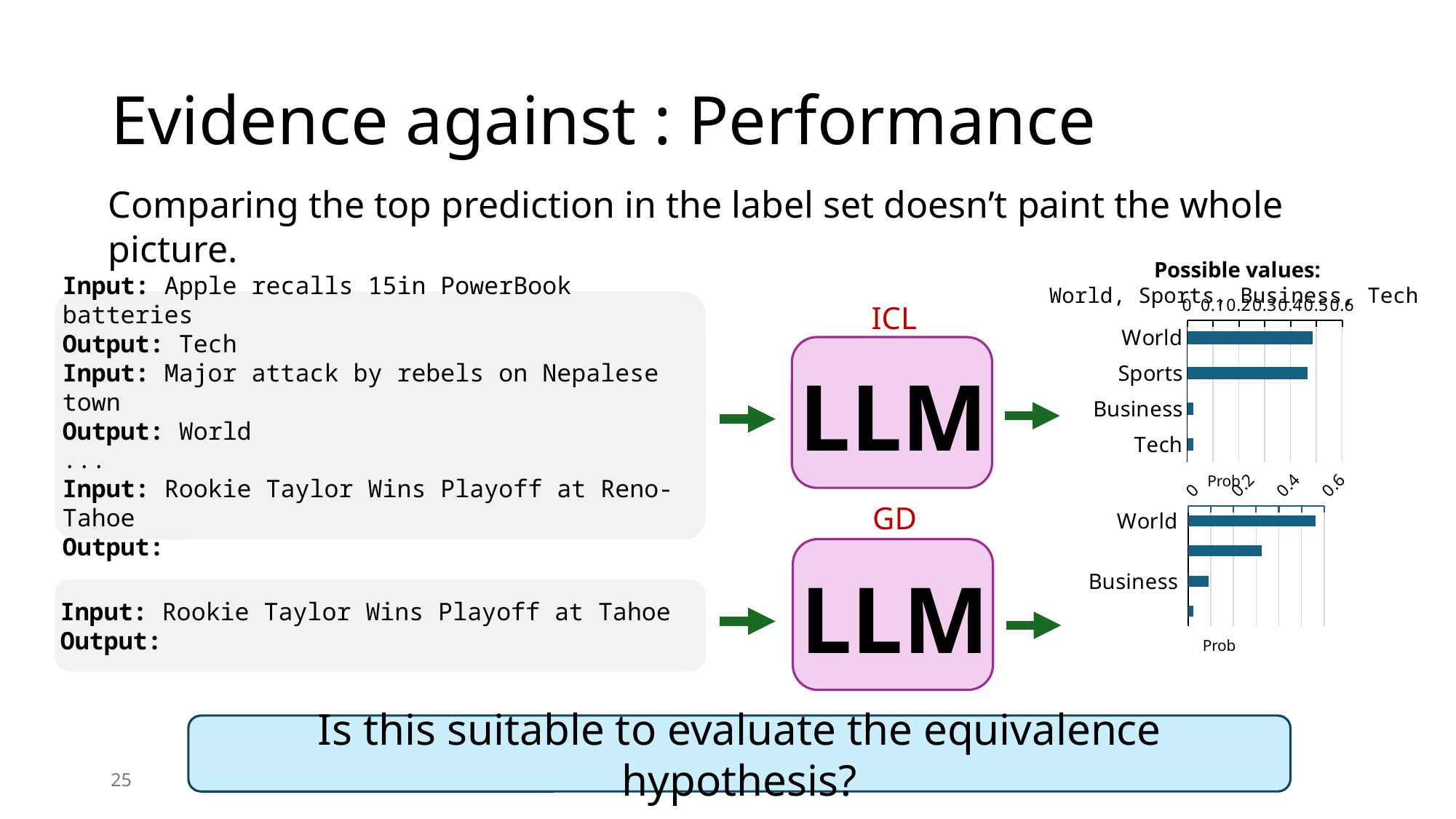
In the top (ICL) chart, which is larger, the value for World or the value for Business? World In the bottom (GD) chart, how many bars are plotted? 4 In the top (ICL) chart, is the value for Sports greater or less than 0.3? greater In the top (ICL) chart, is the value for World greater or less than 0.4? greater In the top (ICL) chart, how many categories are plotted? 4 In the top (ICL) chart, is the value for Tech greater or less than 0.1? less In the bottom (GD) chart, which category has the highest value? World What kind of chart is the top (ICL) chart? bar chart What is the x-axis label of the bottom (GD) chart? Prob